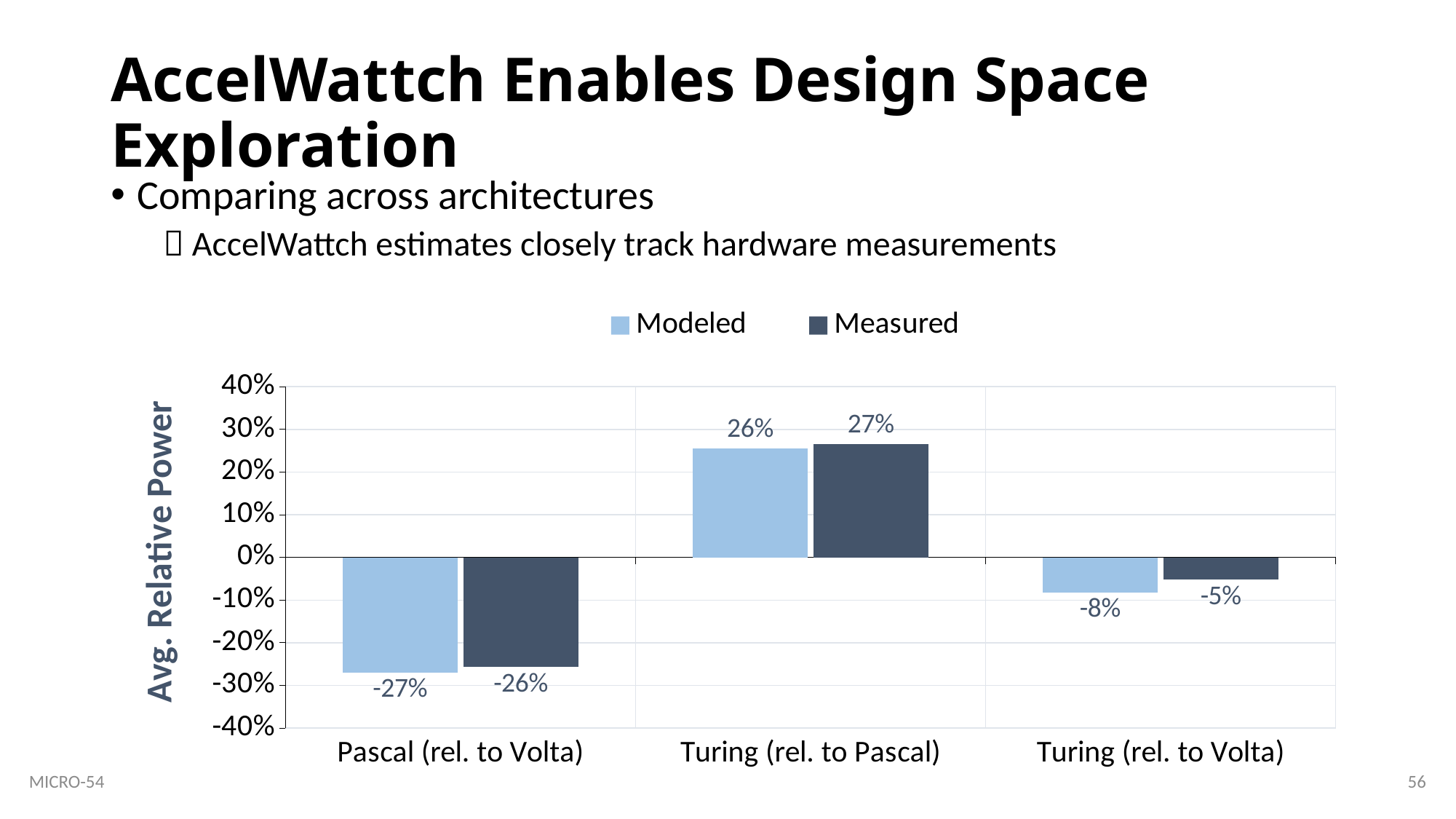
For Pascal (rel. to Volta), which is larger, the Modeled or the Measured value? Measured What is the difference between the Modeled and Measured values for Turing (rel. to Volta)? 3% How many categories are shown on the x axis? 3 What is the Measured value for Turing (rel. to Volta)? -5% What is the label of the y axis? Avg. Relative Power Which category has the highest Measured value? Turing (rel. to Pascal) Which category has the lowest Modeled value? Pascal (rel. to Volta) What kind of chart is shown on the slide? Bar chart How many series does the legend list? 2 What is the Modeled value for Pascal (rel. to Volta)? -27% What is the Measured value for Turing (rel. to Pascal)? 27% What is the Modeled value for Turing (rel. to Volta)? -8%